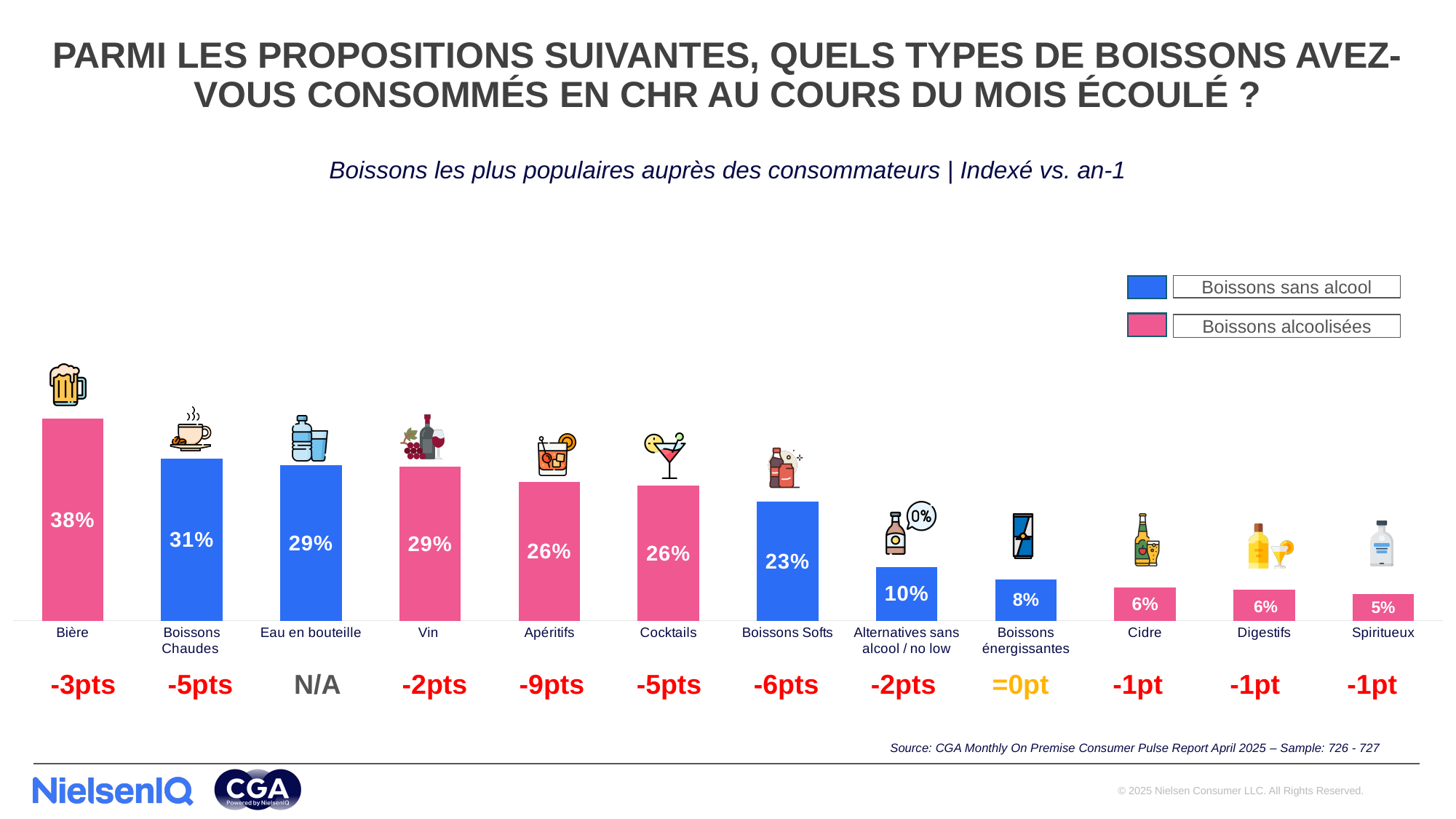
What is the value for Bière? 38% What is the difference between the values for Bière and Boissons Chaudes? 7% Which is larger, the value for Vin or the value for Cocktails? Vin How many categories are shown in the chart? 12 How many series does the legend list? 2 Which category has the lowest value? Spiritueux What is the value for Boissons Softs? 23% Which category has the highest value? Bière What is the value for Alternatives sans alcool / no low? 10% What kind of chart is shown on the slide? Bar chart Which legend entry corresponds to the pink bars? Boissons alcoolisées What is the change versus the previous year shown under Apéritifs? -9pts